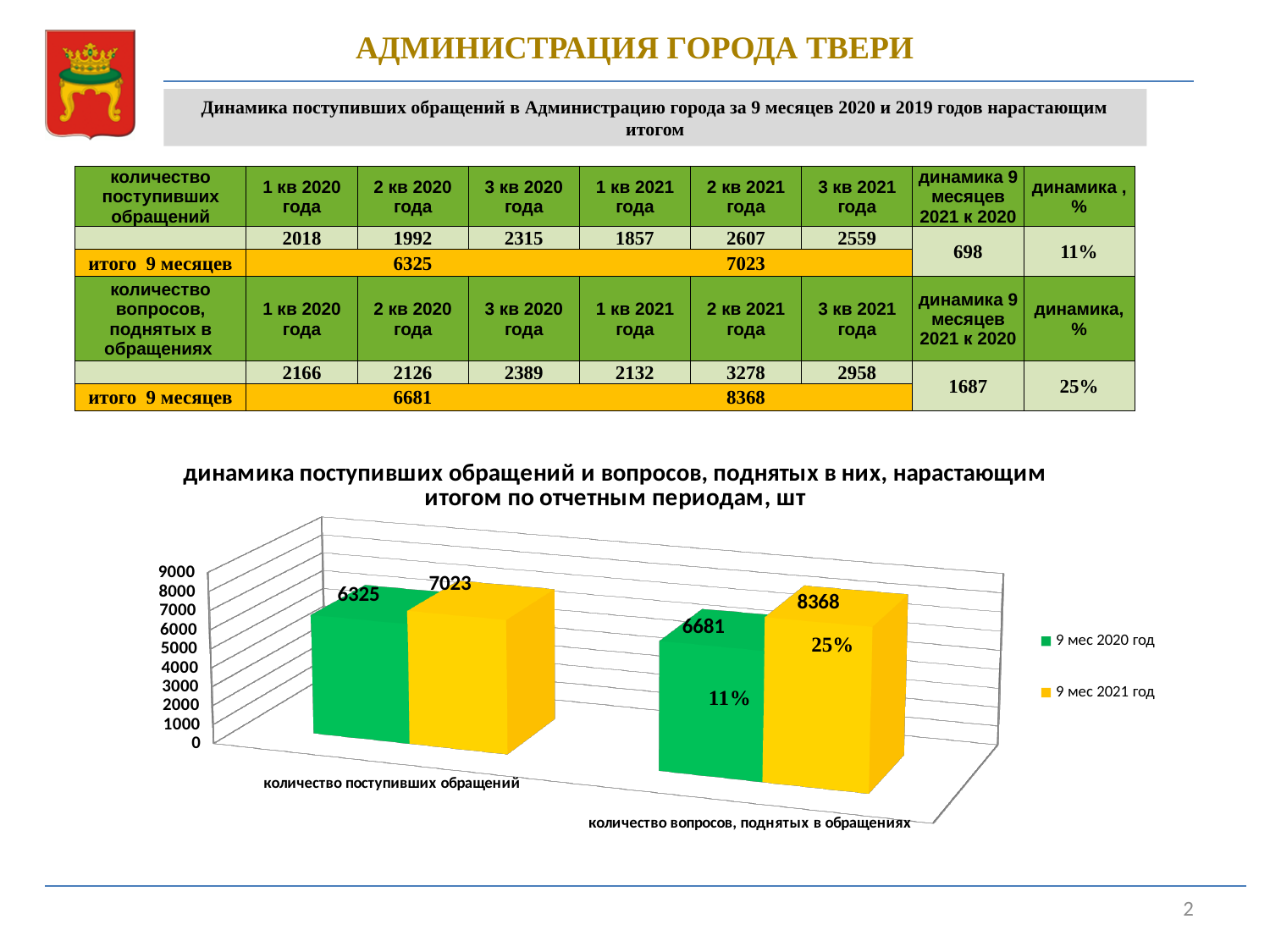
Which bar has the highest value on the chart? 9 мес 2021 год, количество вопросов, поднятых в обращениях What is the difference between the 2021 and 2020 values for "количество вопросов, поднятых в обращениях"? 1687 How many categories are shown on the x axis of the chart? 2 What is the value for "9 мес 2021 год" in the category "количество вопросов, поднятых в обращениях"? 8368 What is the value for "9 мес 2020 год" in the category "количество вопросов, поднятых в обращениях"? 6681 What is the value for "9 мес 2020 год" in the category "количество поступивших обращений"? 6325 Which is larger for "количество поступивших обращений": the 2020 value or the 2021 value? 2021 value What is the value for "9 мес 2021 год" in the category "количество поступивших обращений"? 7023 How many series does the chart legend list? 2 What is the difference between the 2021 and 2020 values for "количество поступивших обращений"? 698 What kind of chart is shown on the slide? bar chart Which bar has the lowest value on the chart? 9 мес 2020 год, количество поступивших обращений